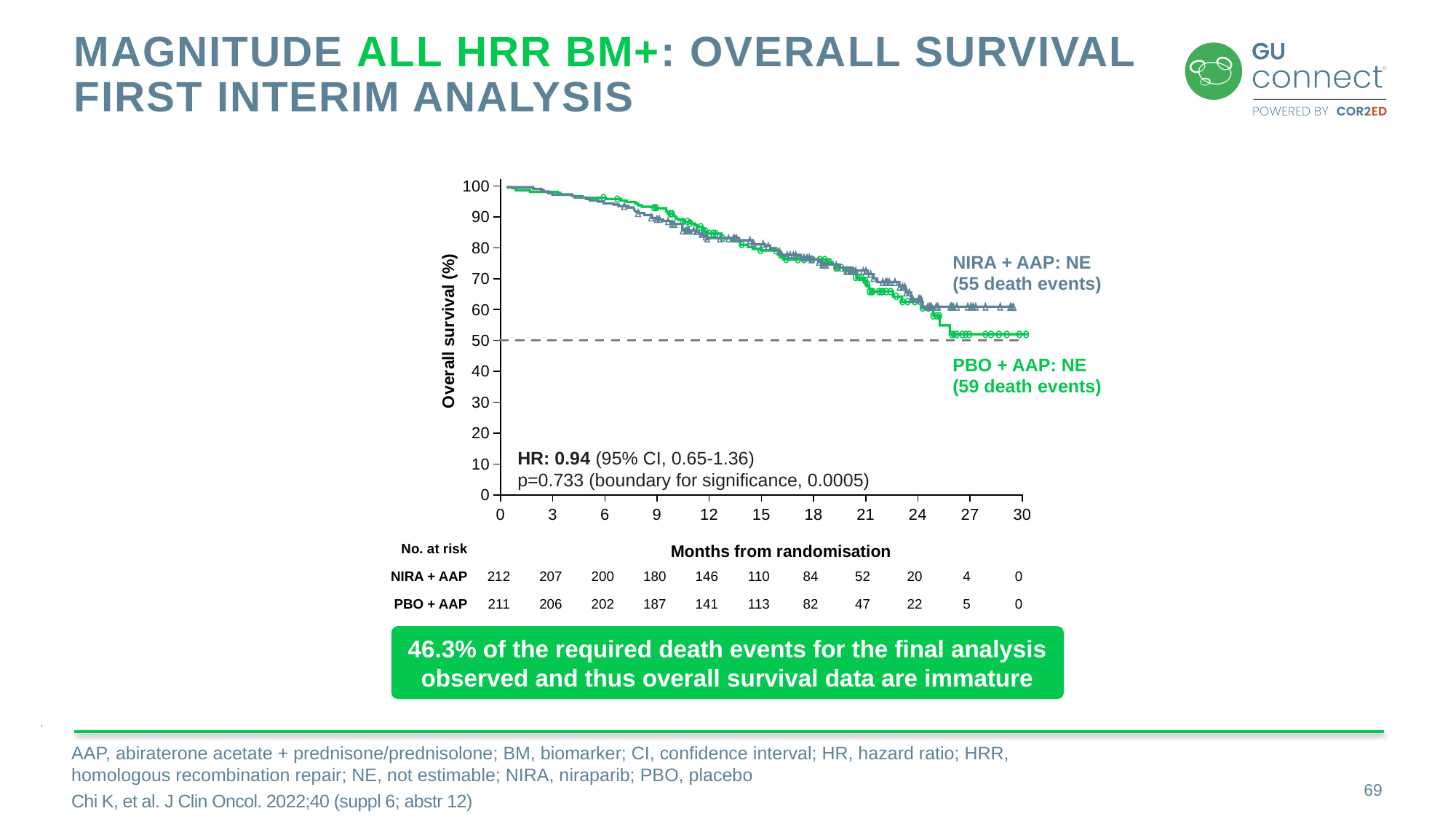
What hazard ratio (HR) is reported on the chart? 0.94 At 21 months, which arm has more patients at risk, NIRA + AAP or PBO + AAP? NIRA + AAP How many death events were observed in the PBO + AAP arm? 59 What kind of chart is shown on the slide? line chart Do the overall survival curves rise or fall as months from randomisation increase? fall What is the number at risk for PBO + AAP at 9 months from randomisation? 187 What is the difference in the number at risk between NIRA + AAP and PBO + AAP at 21 months? 5 What is the difference in the number of death events between the PBO + AAP arm and the NIRA + AAP arm? 4 What is the number at risk for NIRA + AAP at 12 months from randomisation? 146 Is the overall survival for NIRA + AAP at 27 months greater or less than 50%? greater How many death events were observed in the NIRA + AAP arm? 55 How many treatment arms are plotted on the chart? 2